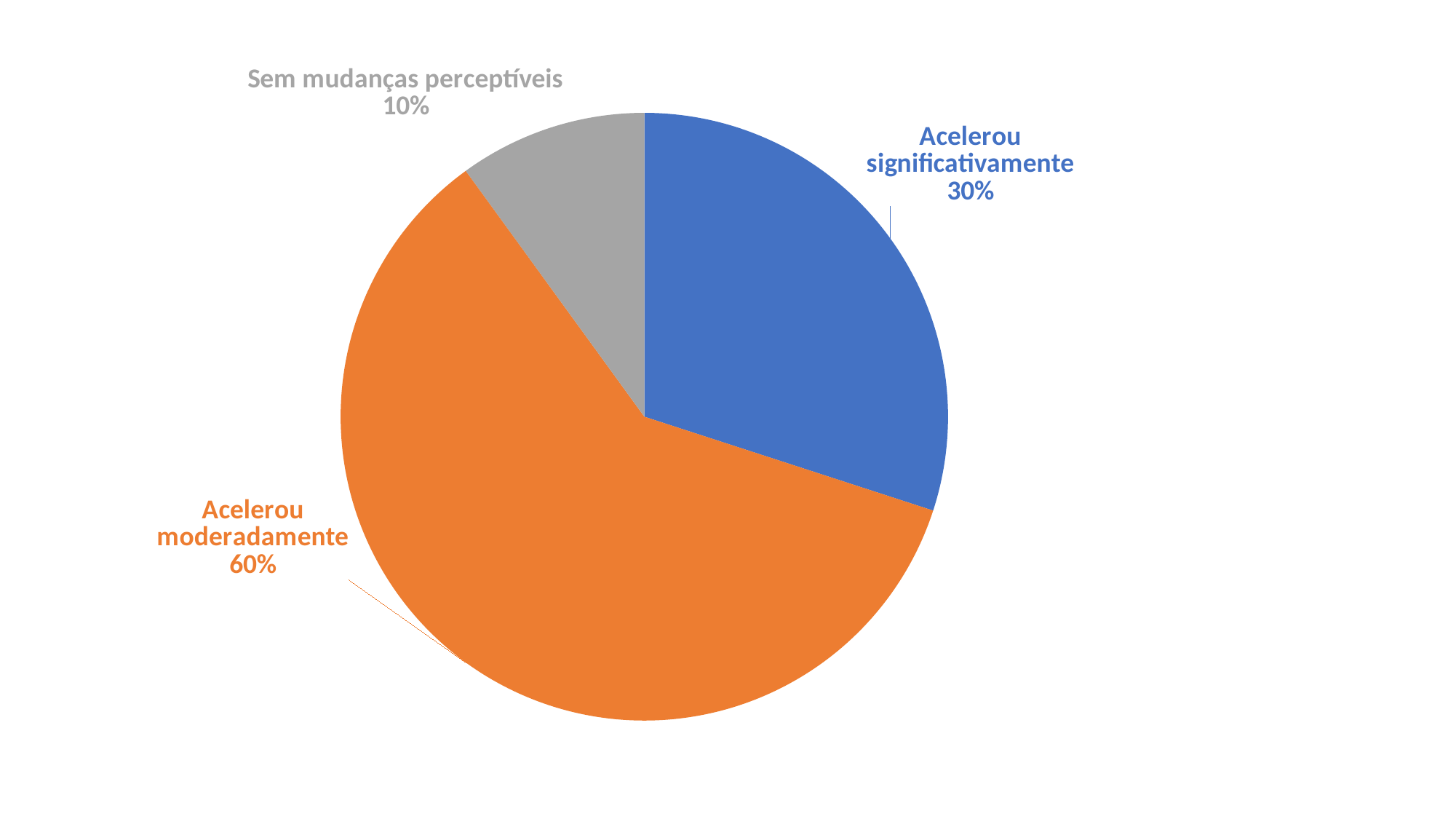
What kind of chart is shown on the slide? pie chart Which category has the smallest slice of the pie? Sem mudanças perceptíveis Which is larger, the slice for "Acelerou significativamente" or the slice for "Sem mudanças perceptíveis"? Acelerou significativamente What colour is the slice for "Sem mudanças perceptíveis"? grey What share of the pie does "Acelerou moderadamente" represent? 60% What share of the pie does "Sem mudanças perceptíveis" represent? 10% What colour is the slice for "Acelerou moderadamente"? orange What is the difference in percentage points between "Acelerou moderadamente" and "Acelerou significativamente"? 30% How many slices does the pie chart have? 3 What is the difference in percentage points between "Acelerou significativamente" and "Sem mudanças perceptíveis"? 20% What share of the pie does "Acelerou significativamente" represent? 30% Which category has the largest slice of the pie? Acelerou moderadamente